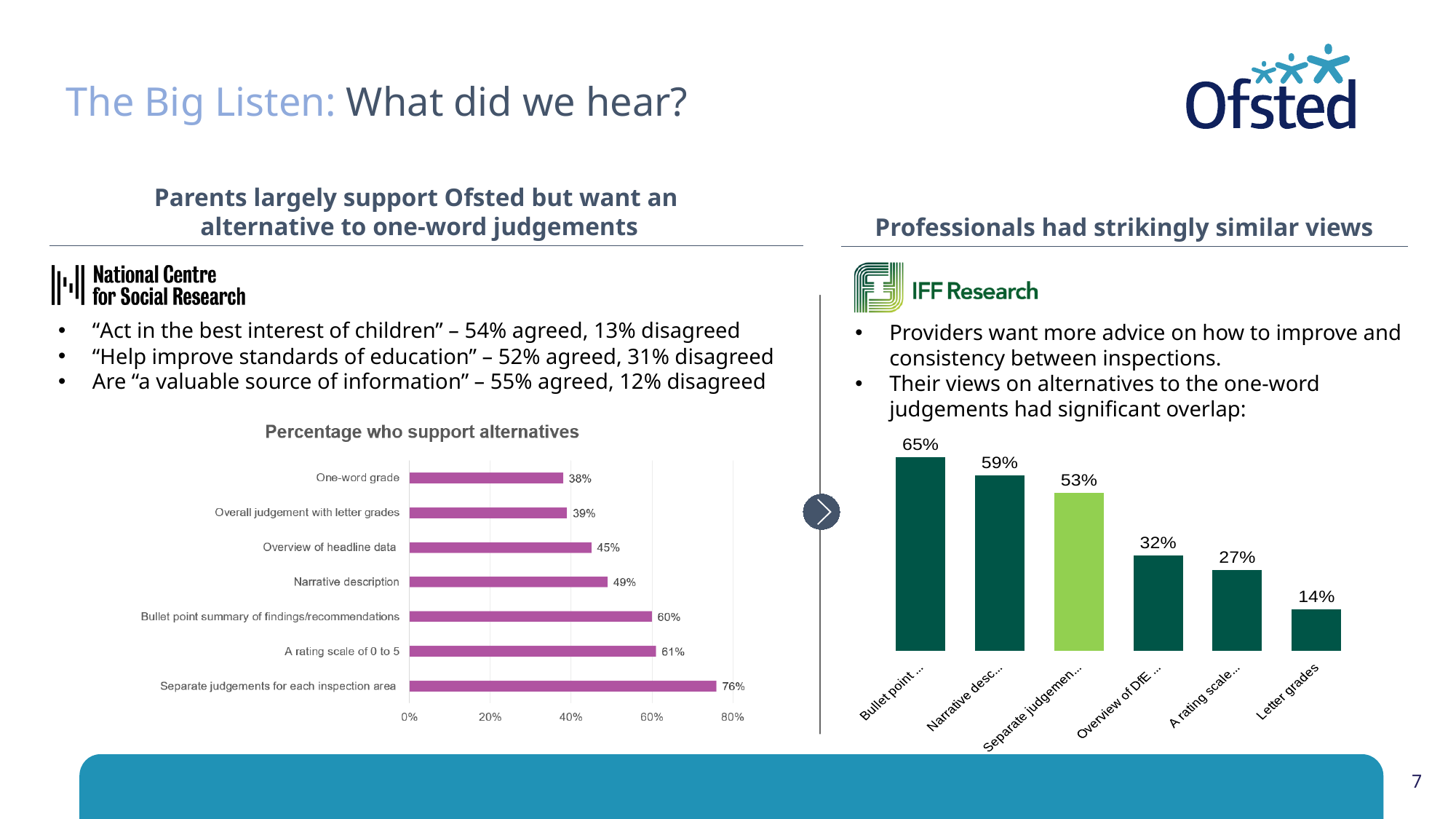
In the 'Percentage who support alternatives' chart, what is the difference between 'A rating scale of 0 to 5' and 'Overview of headline data'? 16% In the 'Percentage who support alternatives' chart, which alternative has the lowest percentage of support? One-word grade In the 'Percentage who support alternatives' chart, what percentage supports 'Separate judgements for each inspection area'? 76% In the 'Percentage who support alternatives' chart, what percentage supports 'Narrative description'? 49% In the chart on the right side of the slide, how many bars are there? 6 In the 'Percentage who support alternatives' chart, which alternative has the highest percentage of support? Separate judgements for each inspection area What type of chart is the 'Percentage who support alternatives' chart? Bar chart In the chart on the right side of the slide, which bar is shown in a lighter green colour than the others? Separate judgemen... In the 'Percentage who support alternatives' chart, how many alternatives are listed? 7 In the chart on the right side of the slide, what is the difference between the 'Narrative desc...' bar and the 'Separate judgemen...' bar? 6% In the chart on the right side of the slide, what is the value of the tallest bar (Bullet point)? 65% In the chart on the right side of the slide, what is the value for 'Letter grades'? 14%